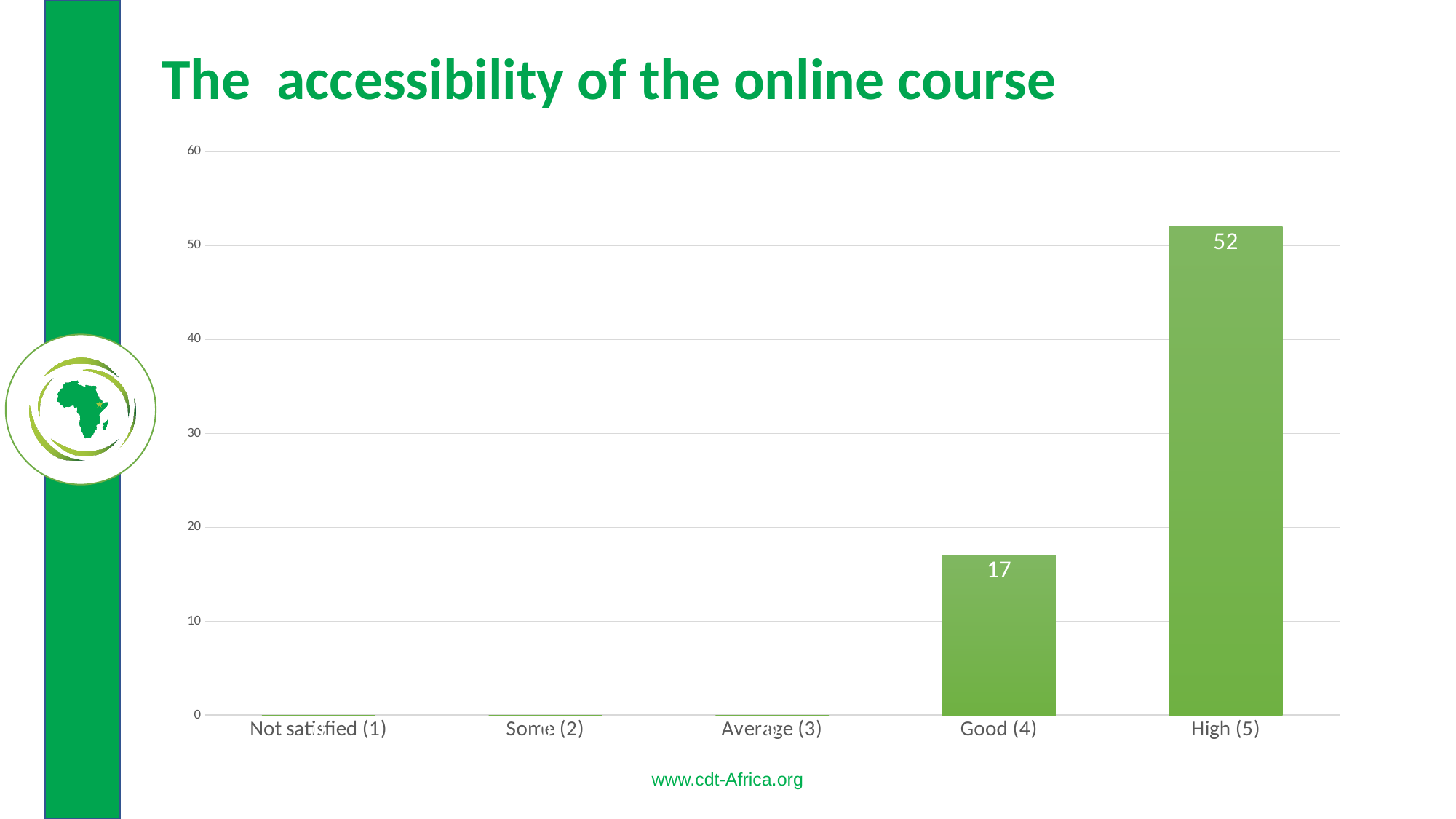
Do the values rise or fall from left to right along the x axis? rise Which is larger, the value for Good (4) or the value for High (5)? High (5) What is the difference between the values for High (5) and Good (4)? 35 Which category has the highest value? High (5) What is the value for Good (4)? 17 What is the title of the slide? The accessibility of the online course What kind of chart is shown on the slide? bar chart What is the value for High (5)? 52 Is the value for Average (3) greater or less than 10? less Is the value for Good (4) greater or less than 20? less How many categories are shown on the x axis? 5 Is the value for High (5) greater or less than 50? greater